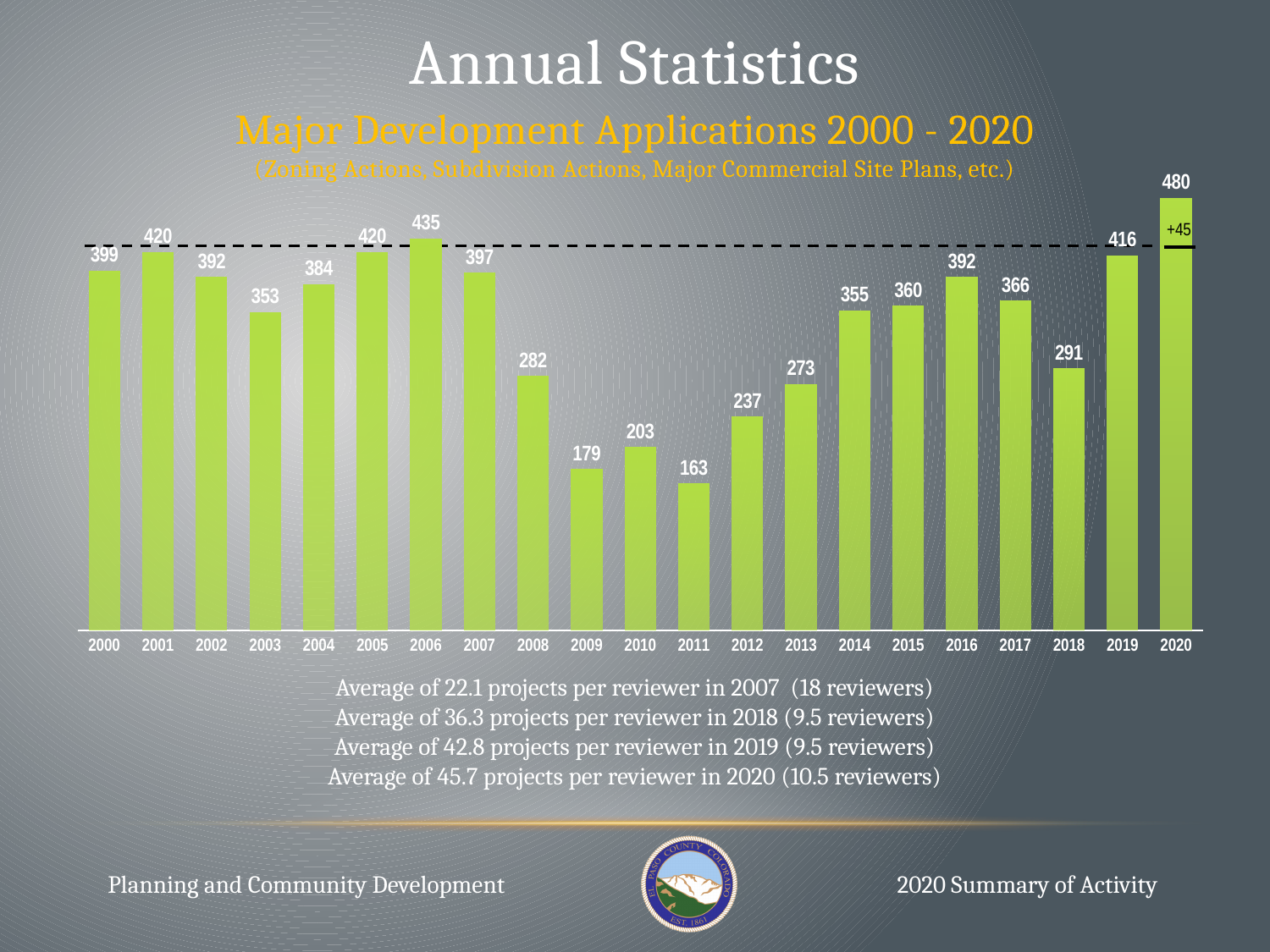
What is the title of the chart? Major Development Applications 2000 - 2020 How many years are shown on the x axis? 21 What is the value for 2011? 163 Which year has the lowest value? 2011 What kind of chart is this? bar chart What is the difference between the values for 2007 and 2008? 115 Which is larger, the value for 2016 or the value for 2017? 2016 Which year has the highest value? 2020 What is the difference between the values for 2020 and 2019? 64 What is the value for 2006? 435 What is the value for 2020? 480 Do the values rise or fall from 2011 to 2016? rise